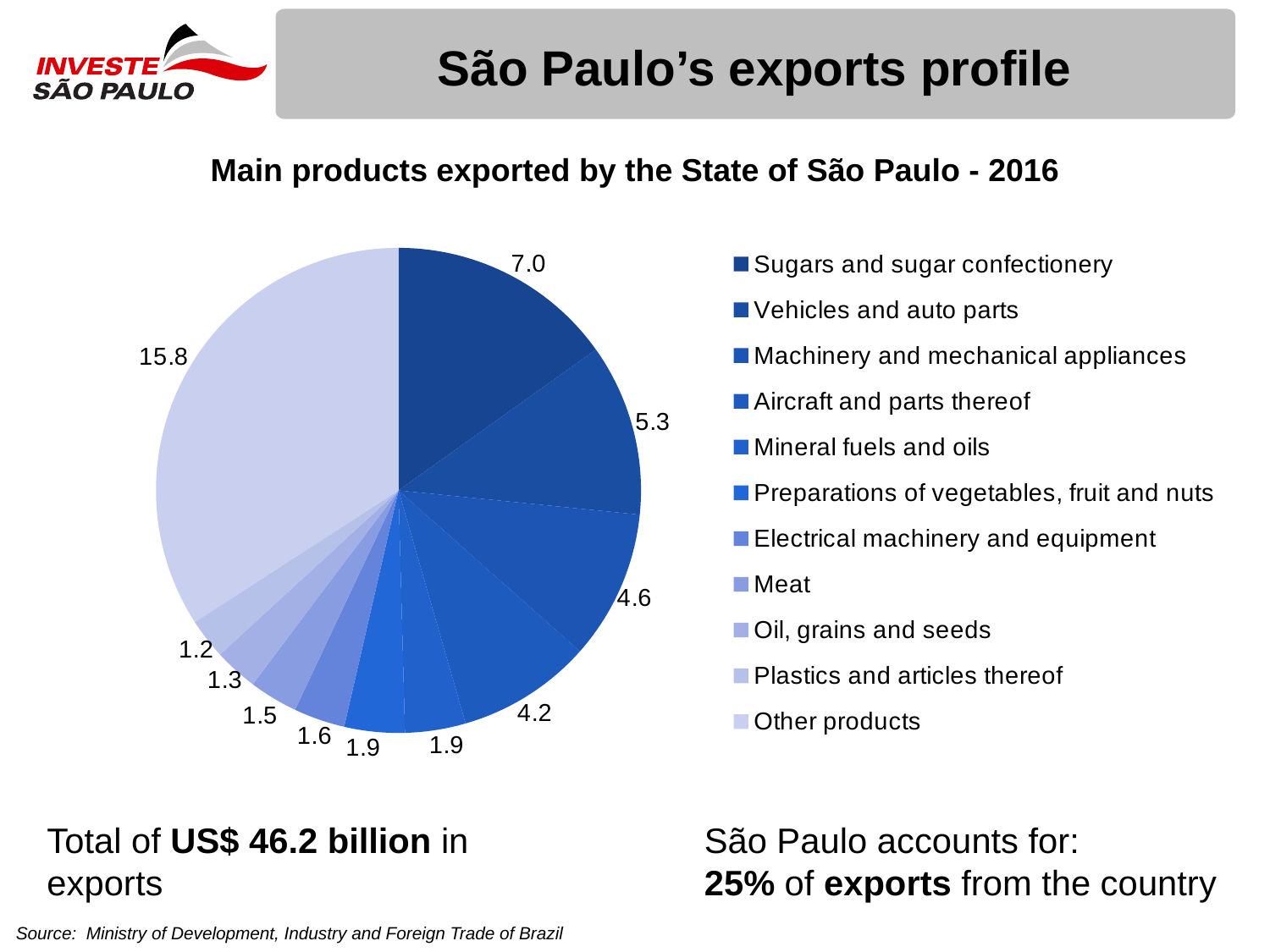
What is the value for Sugars and sugar confectionery? 7.0 How many categories does the legend list? 11 What is the title of the chart? Main products exported by the State of São Paulo - 2016 Which category has the smallest slice of the pie? Plastics and articles thereof What is the value for Machinery and mechanical appliances? 4.6 What type of chart is shown on the slide? pie chart What is the value for Aircraft and parts thereof? 4.2 Which is larger, the value for Machinery and mechanical appliances or the value for Aircraft and parts thereof? Machinery and mechanical appliances What is the difference between the values for Sugars and sugar confectionery and Vehicles and auto parts? 1.7 Which category has the largest slice of the pie? Other products What is the value for Vehicles and auto parts? 5.3 What is the value for Other products? 15.8